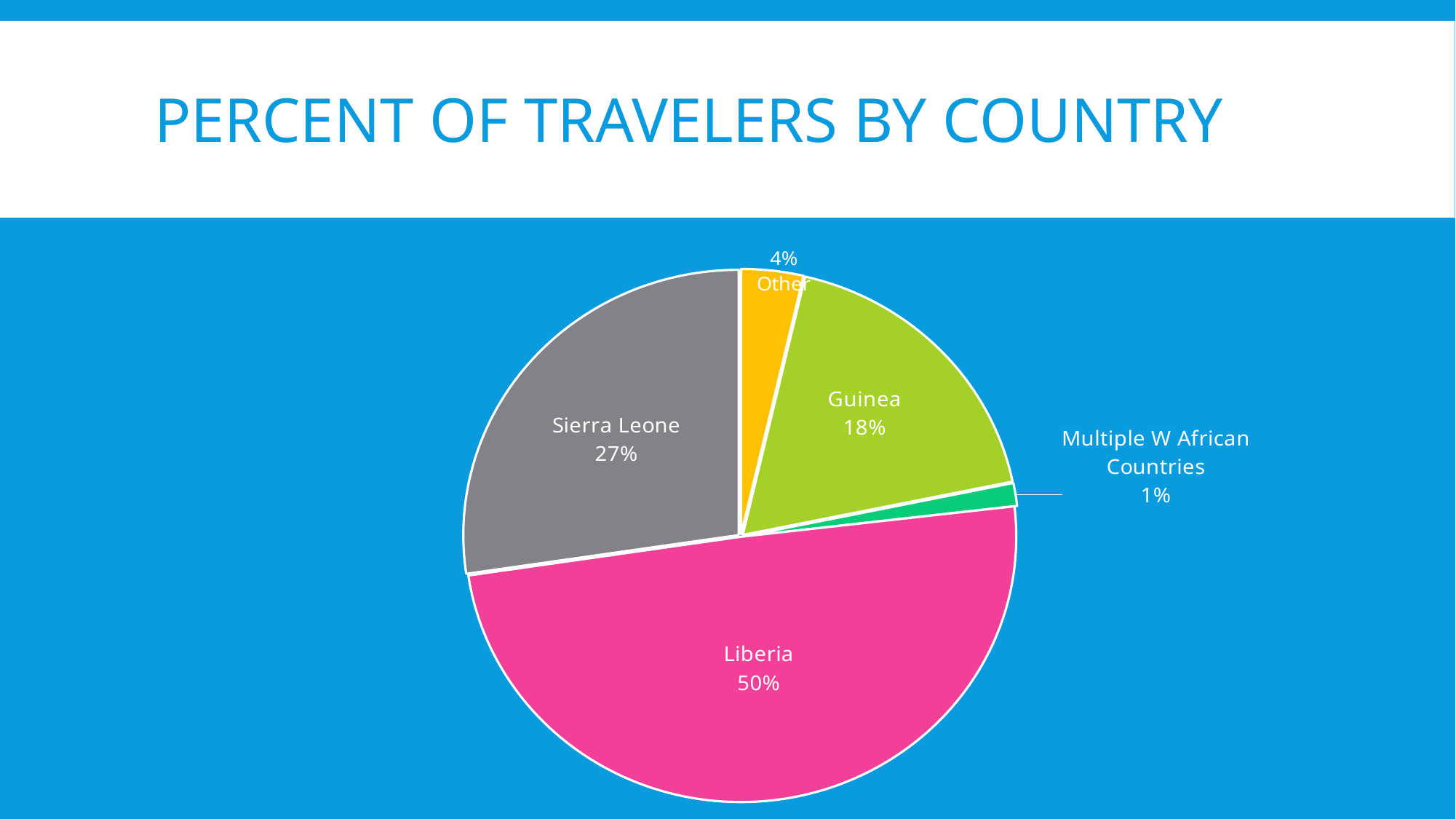
Which category accounts for the smallest share of travelers? Multiple W African Countries What type of chart is shown on the slide? Pie chart What percentage of travelers are from Sierra Leone? 27% What is the title of the chart? Percent of Travelers by Country What percentage of travelers are from Multiple W African Countries? 1% What is the difference in percentage points between Liberia and Sierra Leone? 23 What percentage of travelers are from Liberia? 50% How many slices does the pie chart have? 5 Which country accounts for the largest share of travelers? Liberia What percentage of travelers are from Guinea? 18% Which has a larger share of travelers, Guinea or Sierra Leone? Sierra Leone What percentage of travelers fall under Other? 4%